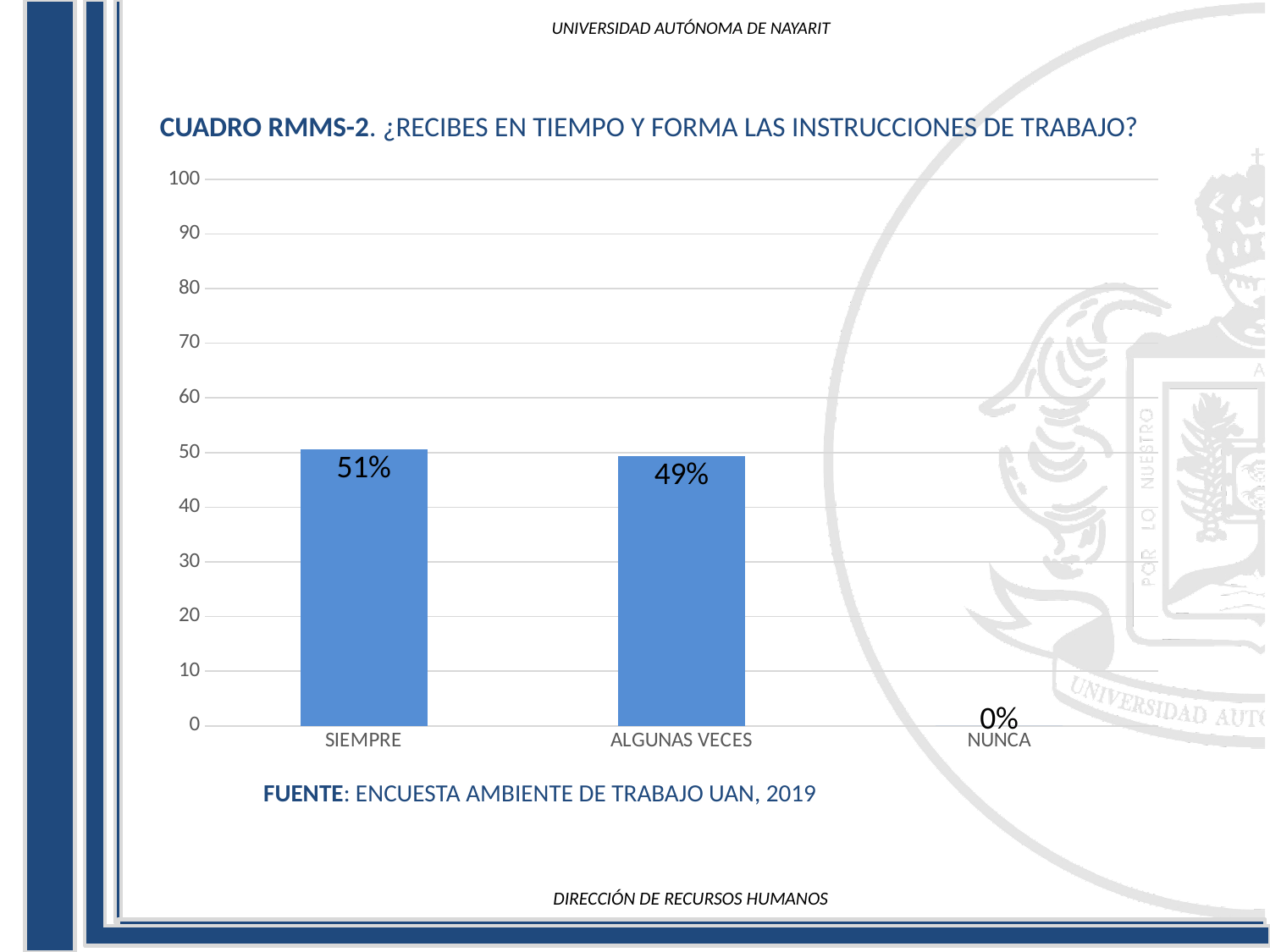
What is the value for NUNCA? 0% Is the value for ALGUNAS VECES greater or less than 50? less What is the value for ALGUNAS VECES? 49% Which is larger, the value for ALGUNAS VECES or the value for NUNCA? ALGUNAS VECES What source is cited below the chart? ENCUESTA AMBIENTE DE TRABAJO UAN, 2019 How many categories are shown on the x axis? 3 Which category has the highest value? SIEMPRE What is the value for SIEMPRE? 51% Which category has the lowest value? NUNCA Do the values rise or fall from left to right along the x axis? fall What is the difference between the values for SIEMPRE and ALGUNAS VECES? 2% What kind of chart is shown on the slide? bar chart